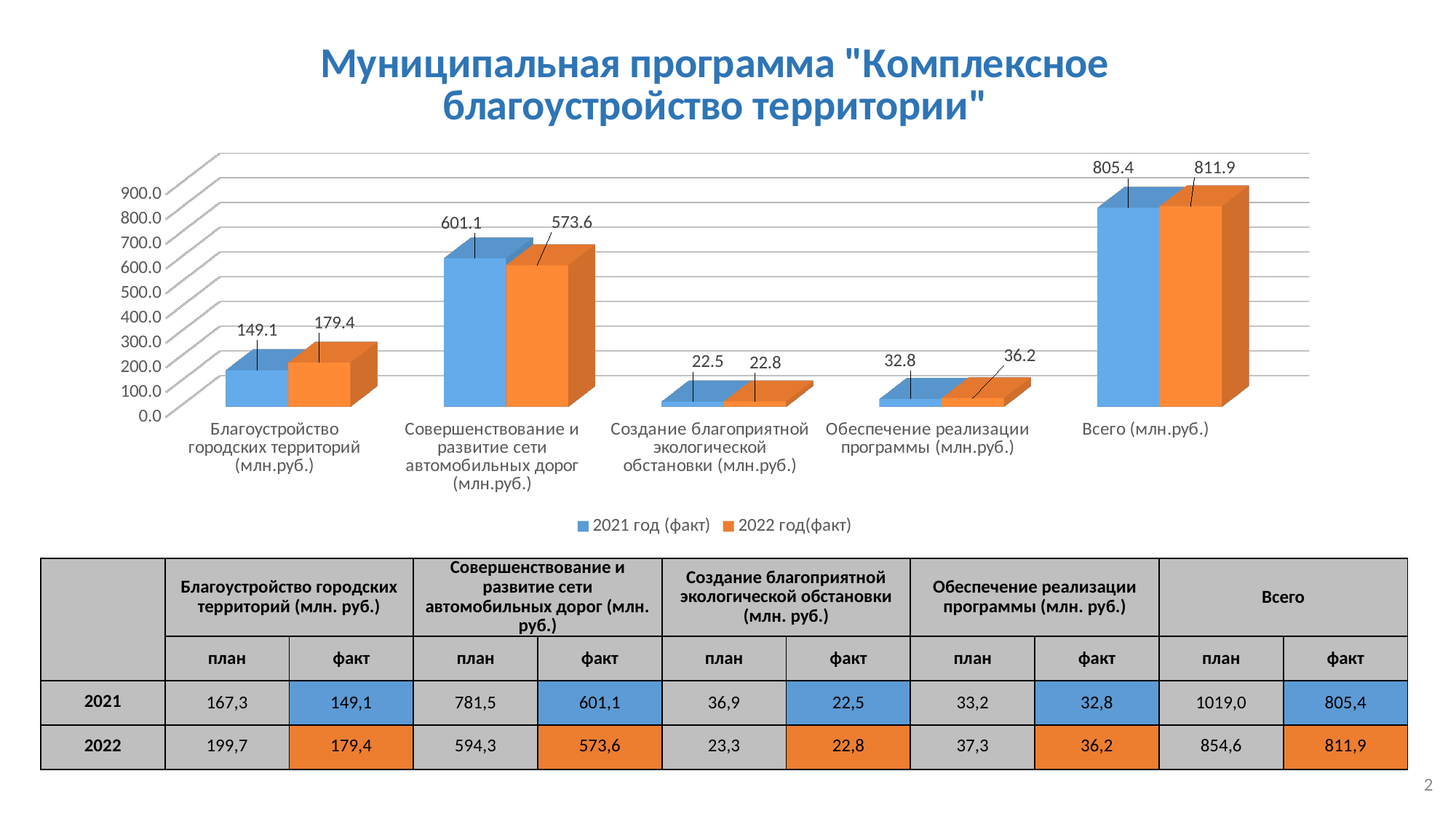
For Совершенствование и развитие сети автомобильных дорог (млн.руб.), which is larger: the 2021 год (факт) value or the 2022 год(факт) value? 2021 год (факт) How many categories are shown on the x axis of the chart? 5 What is the 2021 год (факт) value for Всего (млн.руб.)? 805.4 What type of chart is shown on the slide? Bar chart Which category has the highest 2022 год(факт) value? Всего (млн.руб.) What is the difference between the 2021 год (факт) and 2022 год(факт) values for Совершенствование и развитие сети автомобильных дорог (млн.руб.)? 27.5 What is the 2022 год(факт) value for Обеспечение реализации программы (млн.руб.)? 36.2 What is the 2021 год (факт) value for Совершенствование и развитие сети автомобильных дорог (млн.руб.)? 601.1 What is the difference between the 2022 год(факт) and 2021 год (факт) values for Благоустройство городских территорий (млн.руб.)? 30.3 How many series does the chart legend list? 2 What is the 2022 год(факт) value for Благоустройство городских территорий (млн.руб.)? 179.4 Which category has the lowest 2021 год (факт) value? Создание благоприятной экологической обстановки (млн.руб.)